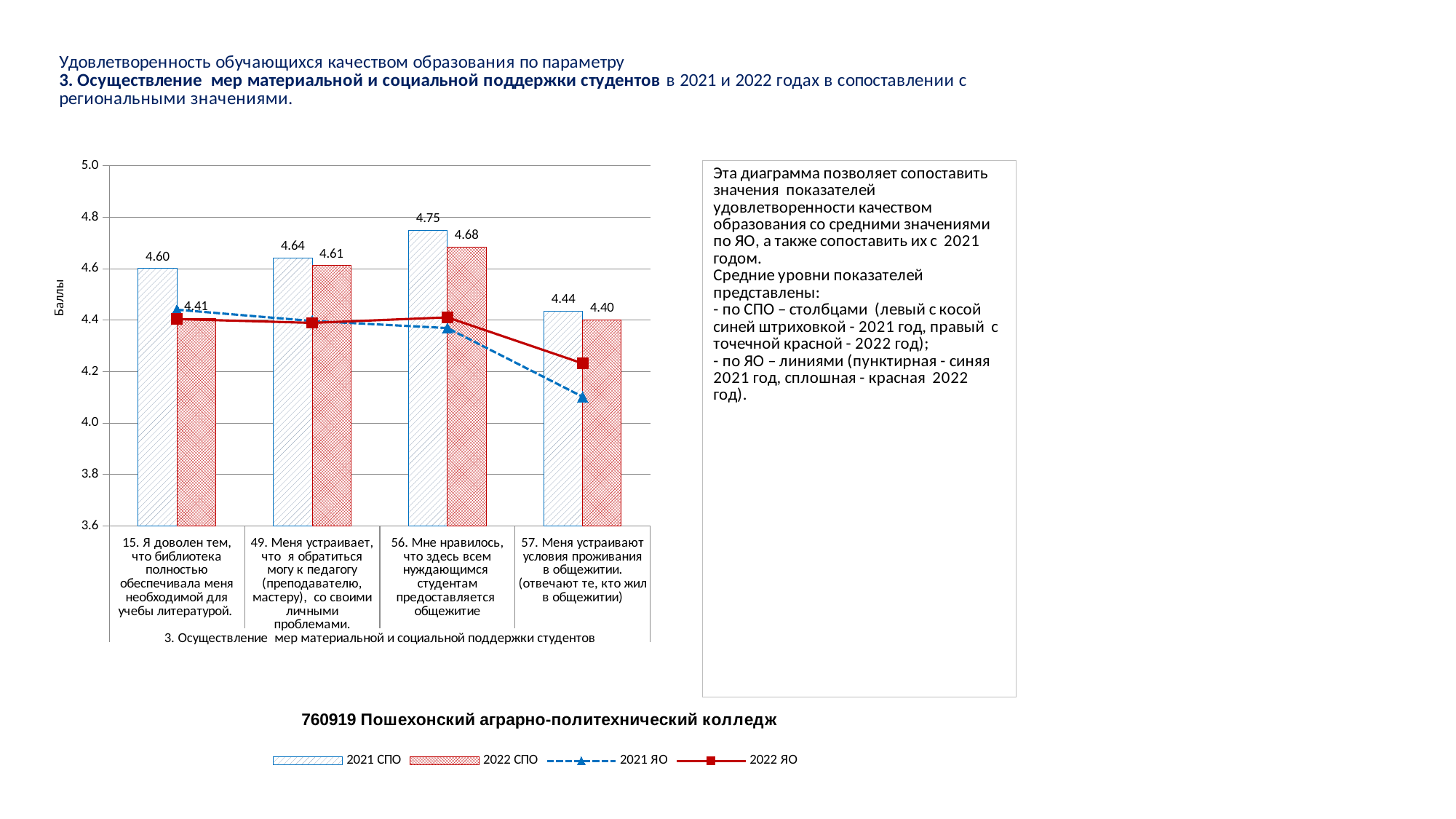
Which item has the lowest 2022 СПО value? 57. Меня устраивают условия проживания в общежитии Is the 2022 ЯО value for item 57 greater or less than 4.4? less For item 49, which is larger: the 2021 СПО value or the 2022 СПО value? 2021 СПО Does the 2021 ЯО line rise or fall from item 15 to item 57? falls How many series does the chart legend list? 4 Which item has the highest 2021 СПО value? 56. Мне нравилось, что здесь всем нуждающимся студентам предоставляется общежитие Is the 2021 ЯО value for item 57 greater or less than 4.2? less What is the 2022 СПО value for item 56 (Мне нравилось, что здесь всем нуждающимся студентам предоставляется общежитие)? 4.68 How many items (categories) are shown on the x axis of the chart? 4 What is the 2022 СПО value for item 49 (Меня устраивает, что я обратиться могу к педагогу)? 4.61 What is the 2021 СПО value for item 15 (Я доволен тем, что библиотека полностью обеспечивала меня необходимой для учебы литературой)? 4.60 What is the difference between the 2021 СПО and 2022 СПО values for item 15? 0.19